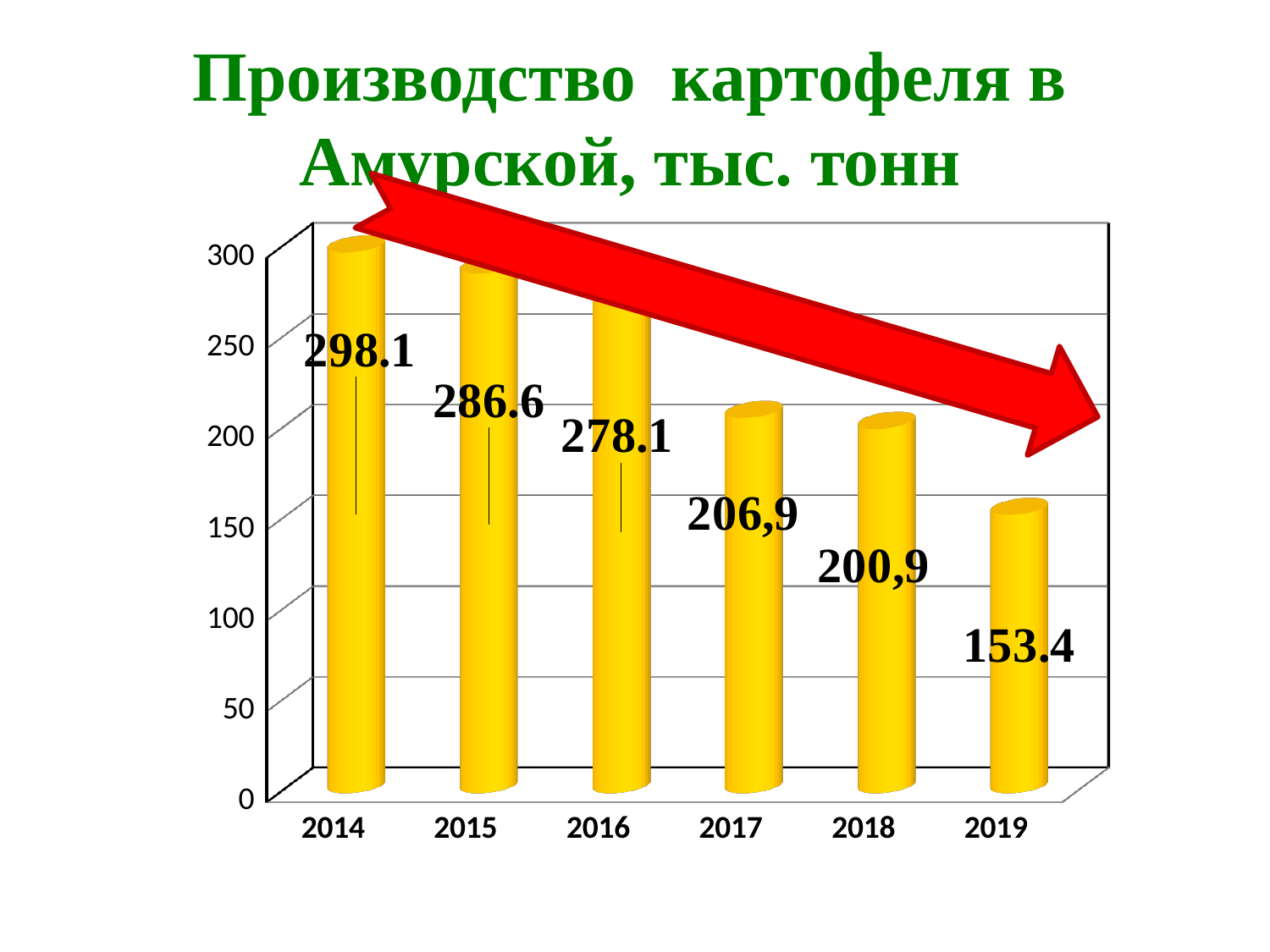
Is the value for 2017 greater or less than 250? less What is the difference between the values for 2014 and 2019? 144.7 What kind of chart is shown on the slide? bar chart What is the value for 2019? 153.4 Which year has the lowest value? 2019 Which is larger, the value for 2016 or the value for 2018? 2016 How many years are shown on the x axis? 6 What is the difference between the values for 2015 and 2016? 8.5 Do the values rise or fall from 2014 to 2019? fall What is the value for 2014? 298.1 What is the value for 2017? 206,9 Which year has the highest value? 2014